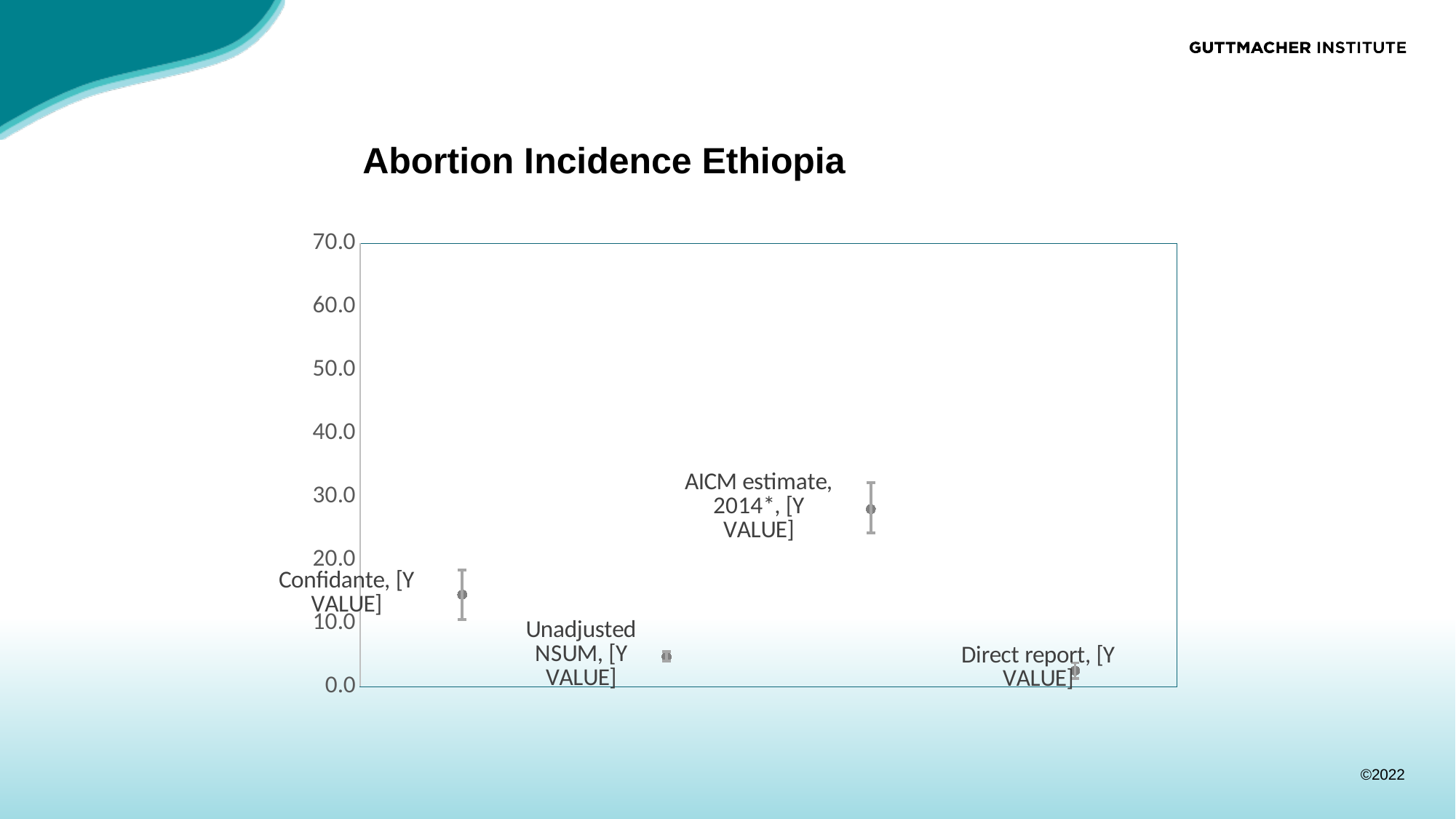
Which data point has the highest value? AICM estimate, 2014* What is the maximum value shown on the y axis? 70.0 Is the value for Unadjusted NSUM greater or less than 10? less Is the value for Confidante greater or less than 10? greater Is the value for Confidante greater or less than 20? less Which is larger, the value for Confidante or the value for Unadjusted NSUM? Confidante What kind of chart is shown on the slide? Scatter plot with error bars How many data points are plotted in the chart? 4 Which is larger, the value for AICM estimate, 2014* or the value for Confidante? AICM estimate, 2014* What is the title of the chart? Abortion Incidence Ethiopia